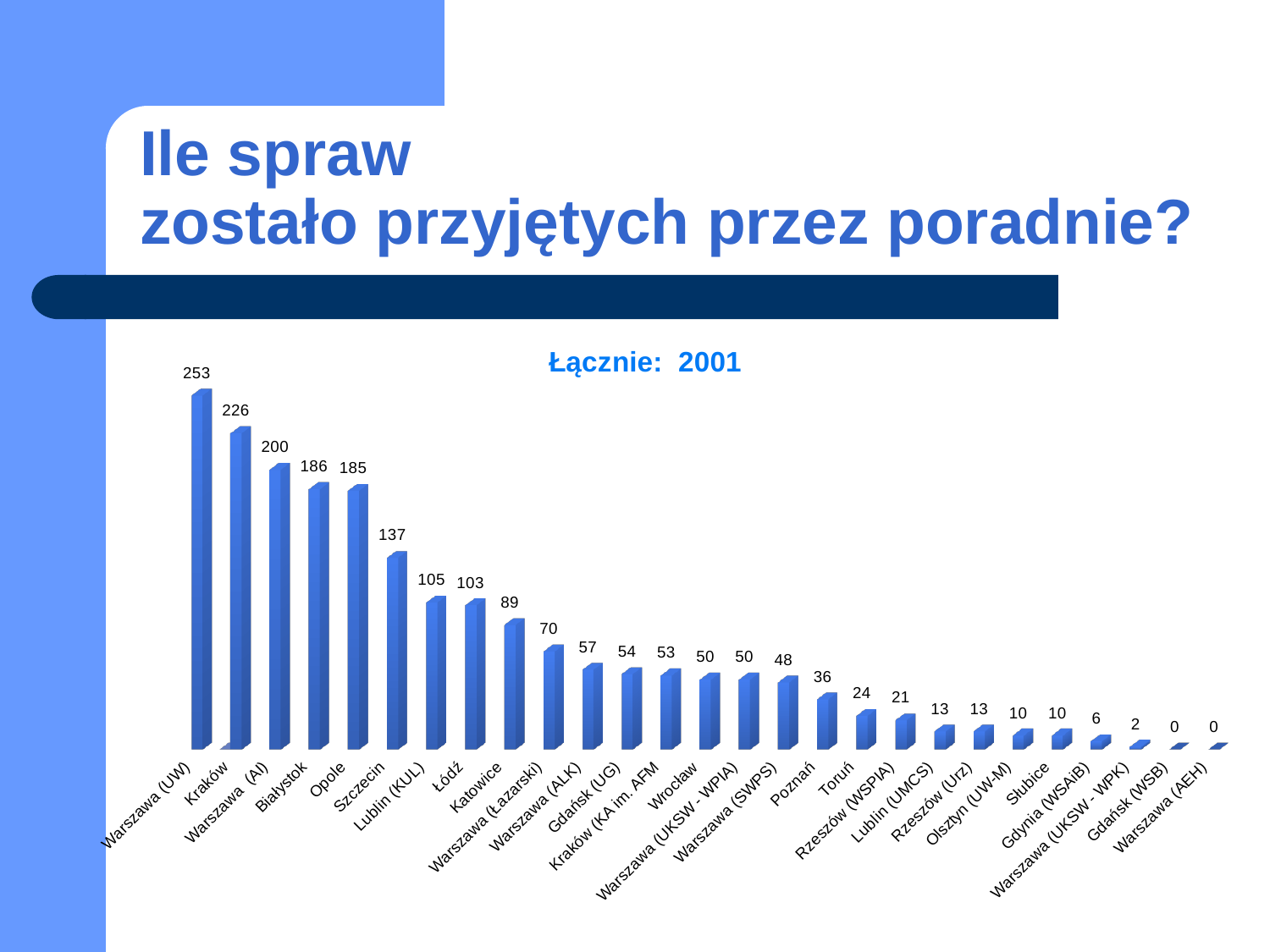
What is the difference between the values for Kraków and Białystok? 40 Which category has the highest value? Warszawa (UW) What value is shown for Poznań? 36 Which is larger, the value for Opole or the value for Łódź? Opole What value is shown for Szczecin? 137 Which is larger, the value for Toruń or the value for Lublin (UMCS)? Toruń Do the values rise or fall from left to right along the x axis? Fall What value is shown for Gdynia (WSAiB)? 6 How many categories are shown on the x axis? 27 What value is shown for Warszawa (UW)? 253 What kind of chart is shown on the slide? Bar chart What is the difference between the values for Lublin (KUL) and Katowice? 16